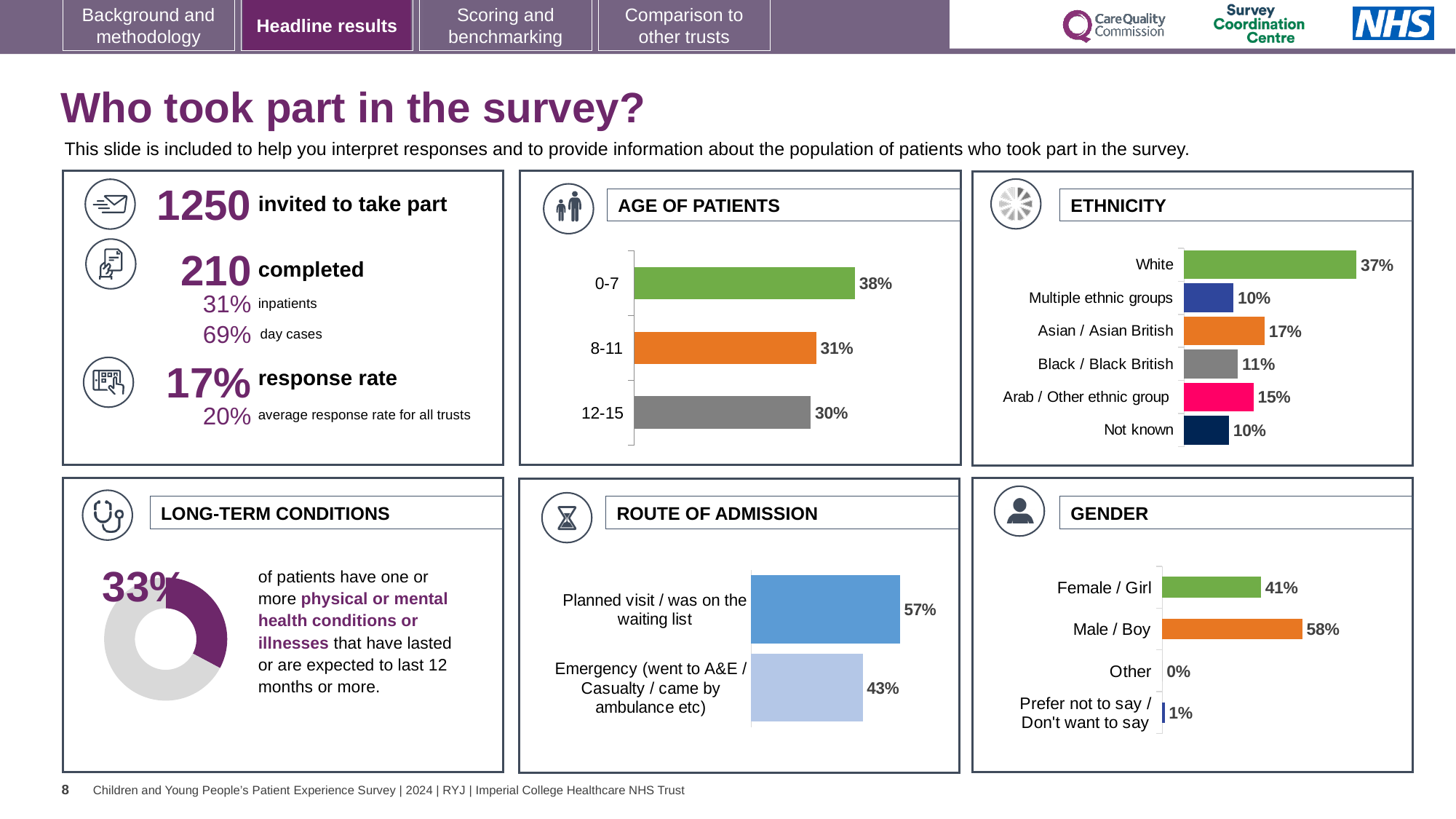
In the ROUTE OF ADMISSION chart, which is larger: Planned visit / was on the waiting list or Emergency? Planned visit / was on the waiting list How many categories are shown in the ETHNICITY chart? 6 In the ETHNICITY chart, which category has the highest value? White In the AGE OF PATIENTS chart, what is the value for the 8-11 age group? 31% In the GENDER chart, which category has the lowest value? Other In the ETHNICITY chart, what is the difference between White and Black / Black British? 26% What type of chart is the AGE OF PATIENTS chart? Bar chart In the GENDER chart, what is the value for Male / Boy? 58% In the ROUTE OF ADMISSION chart, what is the value for Emergency (went to A&E / Casualty / came by ambulance etc)? 43% In the AGE OF PATIENTS chart, which age group has the highest value? 0-7 In the ETHNICITY chart, what is the value for Asian / Asian British? 17% In the GENDER chart, what is the difference between Male / Boy and Female / Girl? 17%